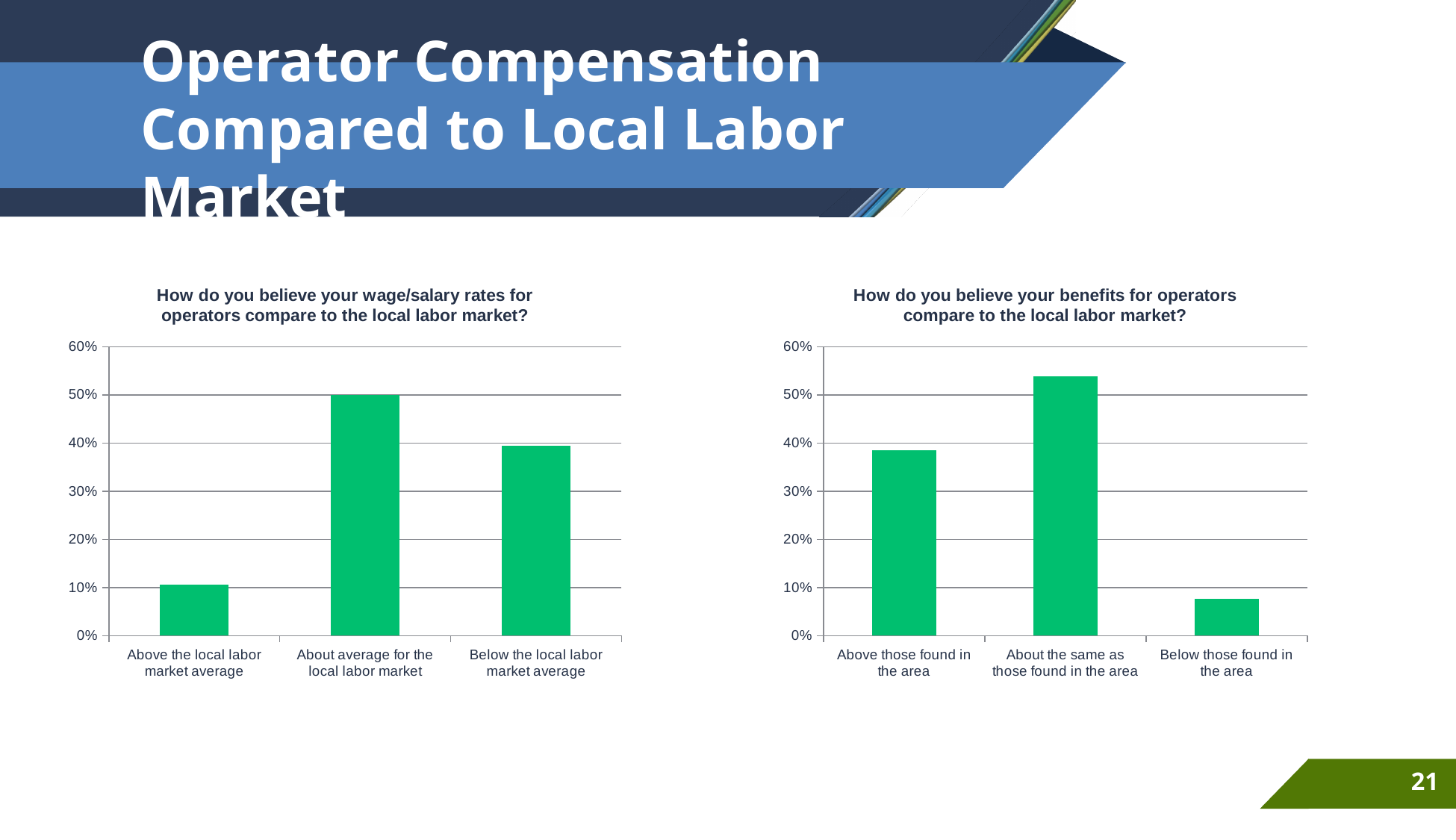
In the right chart (benefits for operators), which is larger: 'Above those found in the area' or 'Below those found in the area'? Above those found in the area What is the title of the left chart? How do you believe your wage/salary rates for operators compare to the local labor market? In the right chart (benefits for operators), is the value for 'Below those found in the area' greater or less than 10%? less In the right chart (benefits for operators), which category has the lowest value? Below those found in the area In the right chart (benefits for operators), is the value for 'Above those found in the area' greater or less than 30%? greater In the left chart (wage/salary rates), is the value for 'Above the local labor market average' greater or less than 20%? less In the left chart (wage/salary rates), which category has the highest value? About average for the local labor market What kind of chart is the right chart (benefits for operators)? Bar chart In the right chart (benefits for operators), which category has the highest value? About the same as those found in the area How many categories are shown in the left chart (wage/salary rates)? 3 In the left chart (wage/salary rates), which category has the lowest value? Above the local labor market average